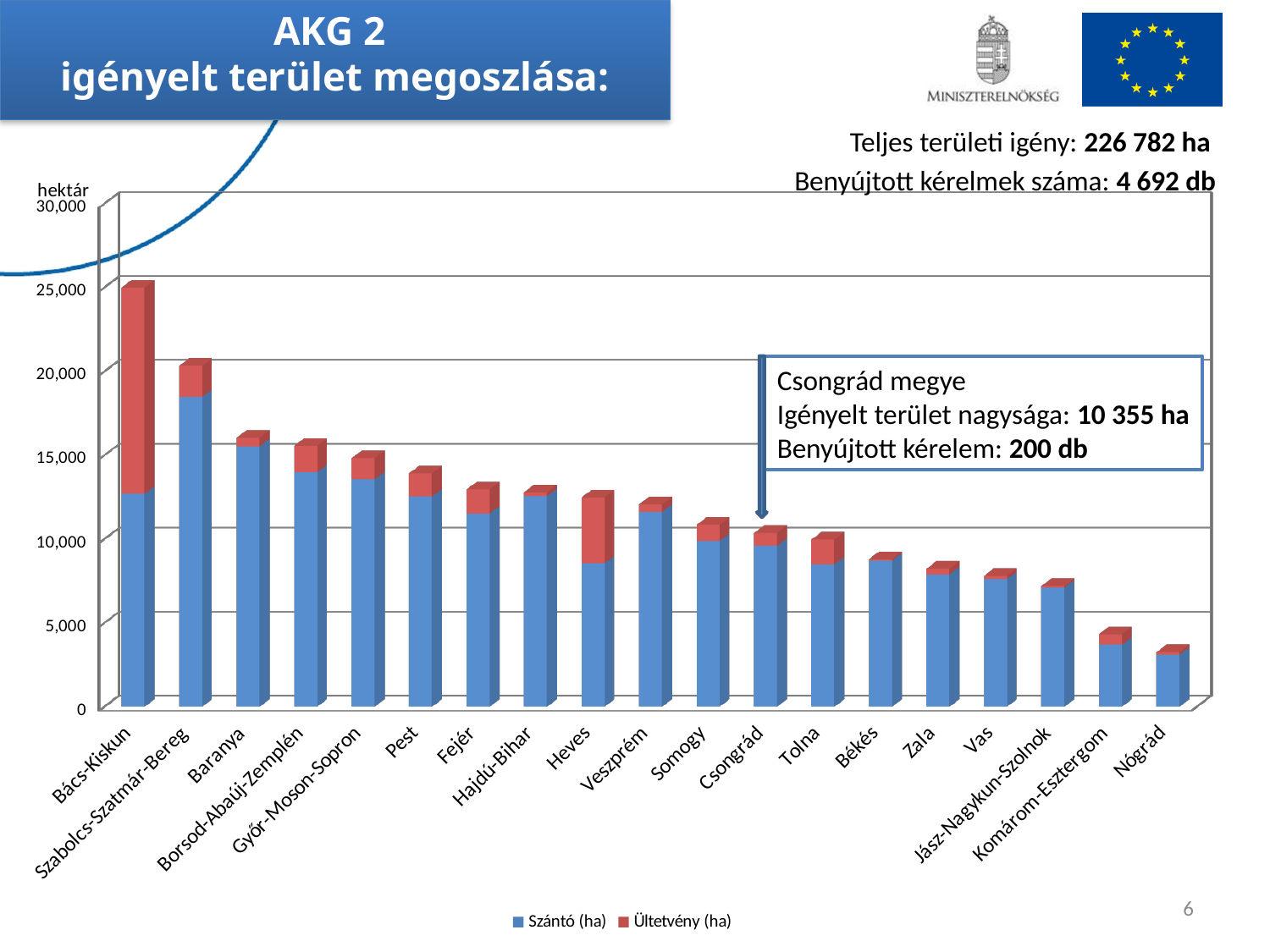
How many series does the legend list? 2 Which county has the highest total bar? Bács-Kiskun What kind of chart is shown on the slide? bar chart According to the callout, what is the requested area (igényelt terület) for Csongrád county? 10 355 ha How many counties (categories) are shown on the x axis? 19 Which has a larger total bar, Heves or Zala? Heves Is the total value for Békés greater or less than 10,000? less Which county has the lowest total bar? Nógrád Do the total bar heights rise or fall moving from left to right along the x axis? fall What are the two series named in the legend? Szántó (ha) and Ültetvény (ha) Is the total value for Nógrád greater or less than 5,000? less Is the total value for Bács-Kiskun greater or less than 20,000? greater